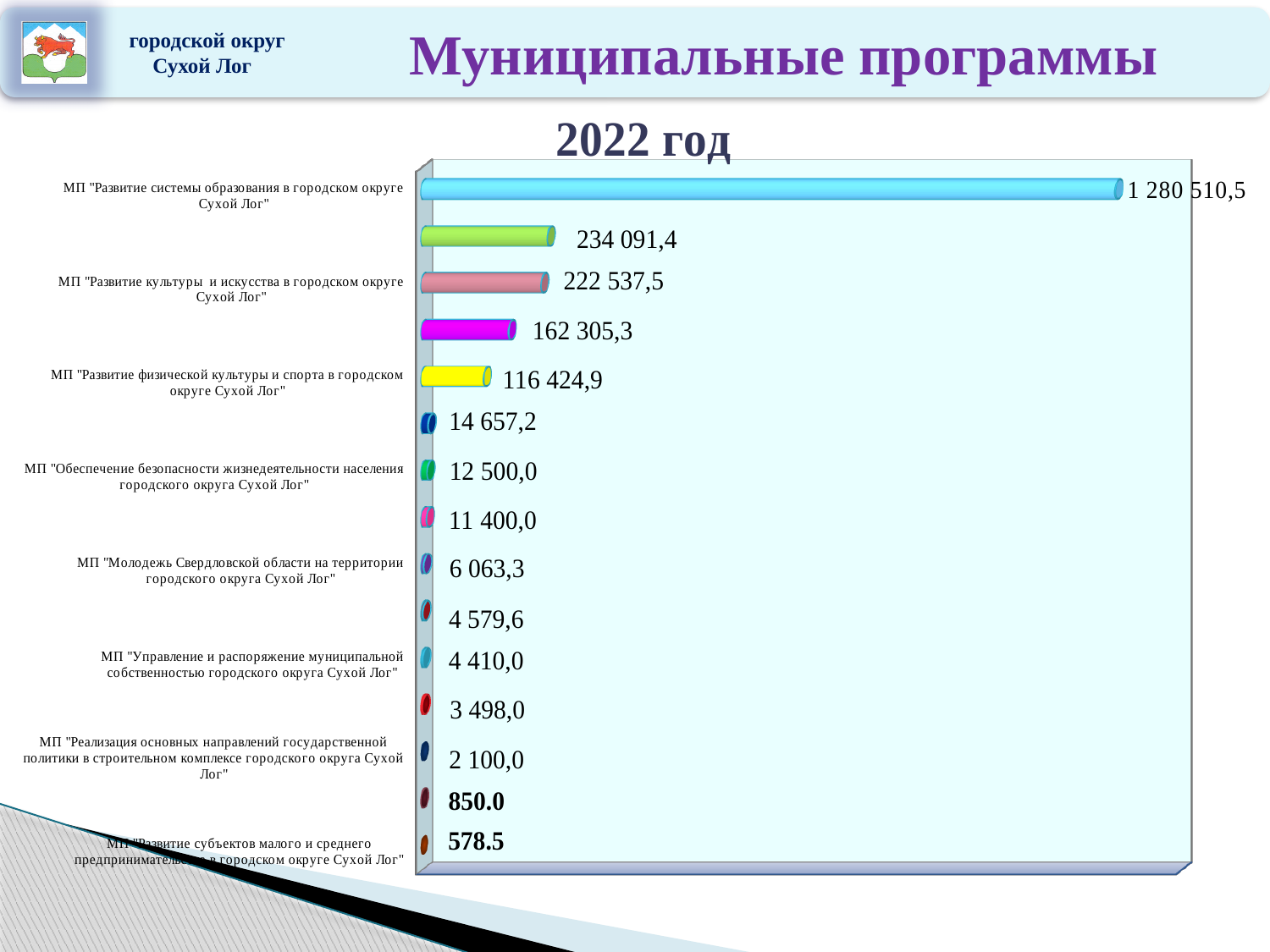
What is the value for МП "Развитие субъектов малого и среднего предпринимательства в городском округе Сухой Лог"? 578.5 What is the value for МП "Развитие физической культуры и спорта в городском округе Сухой Лог"? 116 424,9 What is the value for МП "Развитие системы образования в городском округе Сухой Лог"? 1 280 510,5 What is the value for МП "Развитие культуры и искусства в городском округе Сухой Лог"? 222 537,5 What is the difference between the value for МП "Развитие системы образования" and the value for МП "Развитие культуры и искусства"? 1 057 973,0 What is the smallest value shown in the chart? 578.5 What type of chart is shown on the slide? bar chart How many bars are plotted in the chart? 15 Which is larger: the value for МП "Развитие культуры и искусства" or the value for МП "Развитие физической культуры и спорта"? МП "Развитие культуры и искусства" What is the title of the chart? 2022 год Which program has the highest value in the chart? МП "Развитие системы образования в городском округе Сухой Лог" What is the difference between the second-largest value (234 091,4) and the value for МП "Развитие культуры и искусства" (222 537,5)? 11 553,9